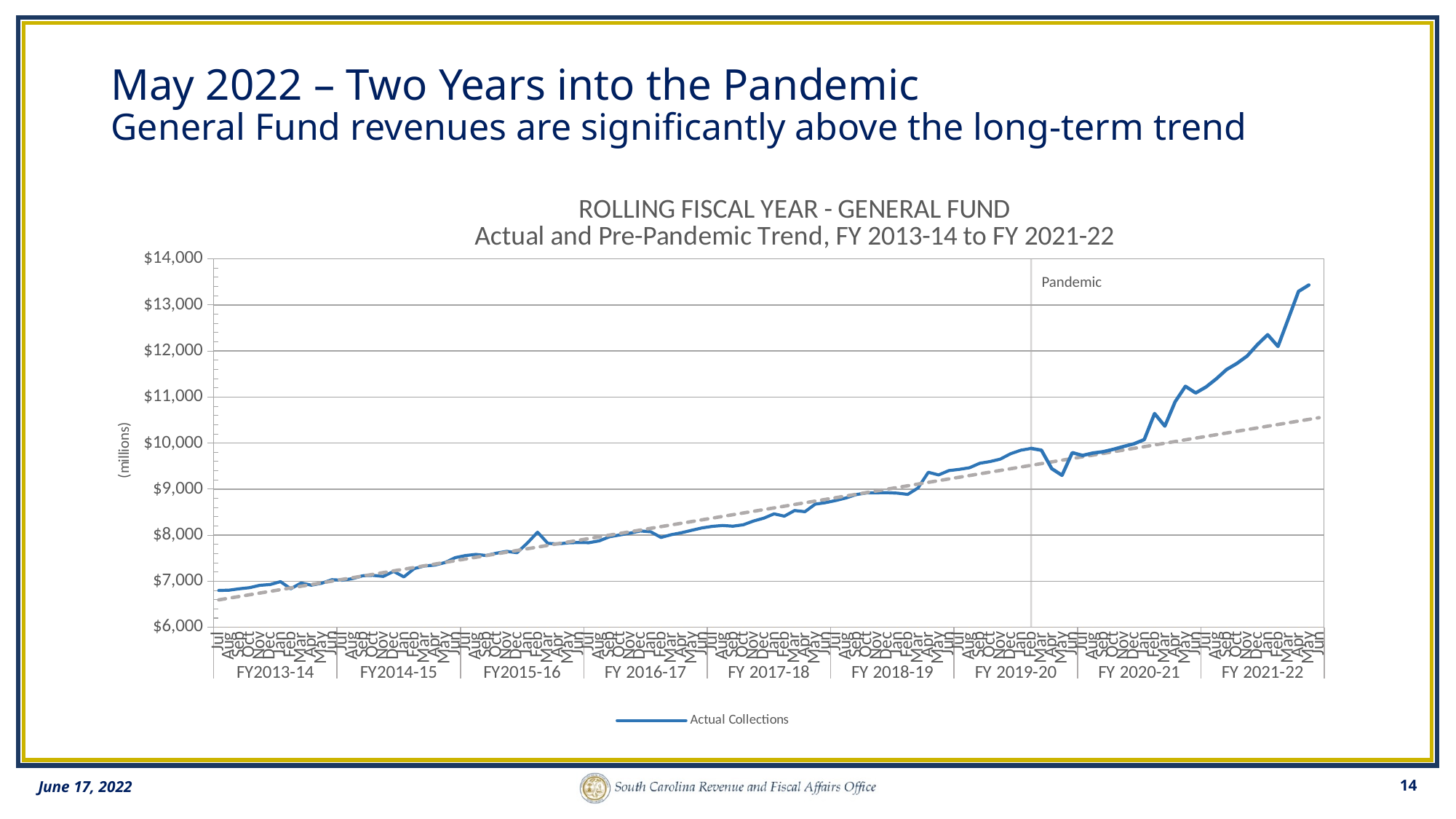
Is the value of Actual Collections in May of FY 2021-22 greater or less than $13,000? greater In which fiscal year does the Actual Collections line reach its highest point? FY 2021-22 Is the value of Actual Collections in Jun of FY 2018-19 greater or less than $9,000? greater What kind of chart is shown on the slide? Line chart How many fiscal years are labelled along the x axis? 9 How many series does the chart legend list? 1 Which is larger, Actual Collections in May of FY 2021-22 or in Jul of FY2013-14? May of FY 2021-22 What is the title of the chart? ROLLING FISCAL YEAR - GENERAL FUND Actual and Pre-Pandemic Trend, FY 2013-14 to FY 2021-22 Is the value of Actual Collections in Jul of FY2013-14 greater or less than $7,000? less Do Actual Collections generally rise or fall from FY2013-14 to FY 2021-22? Rise What label marks the vertical line drawn in the chart near the start of FY 2019-20's final months? Pandemic